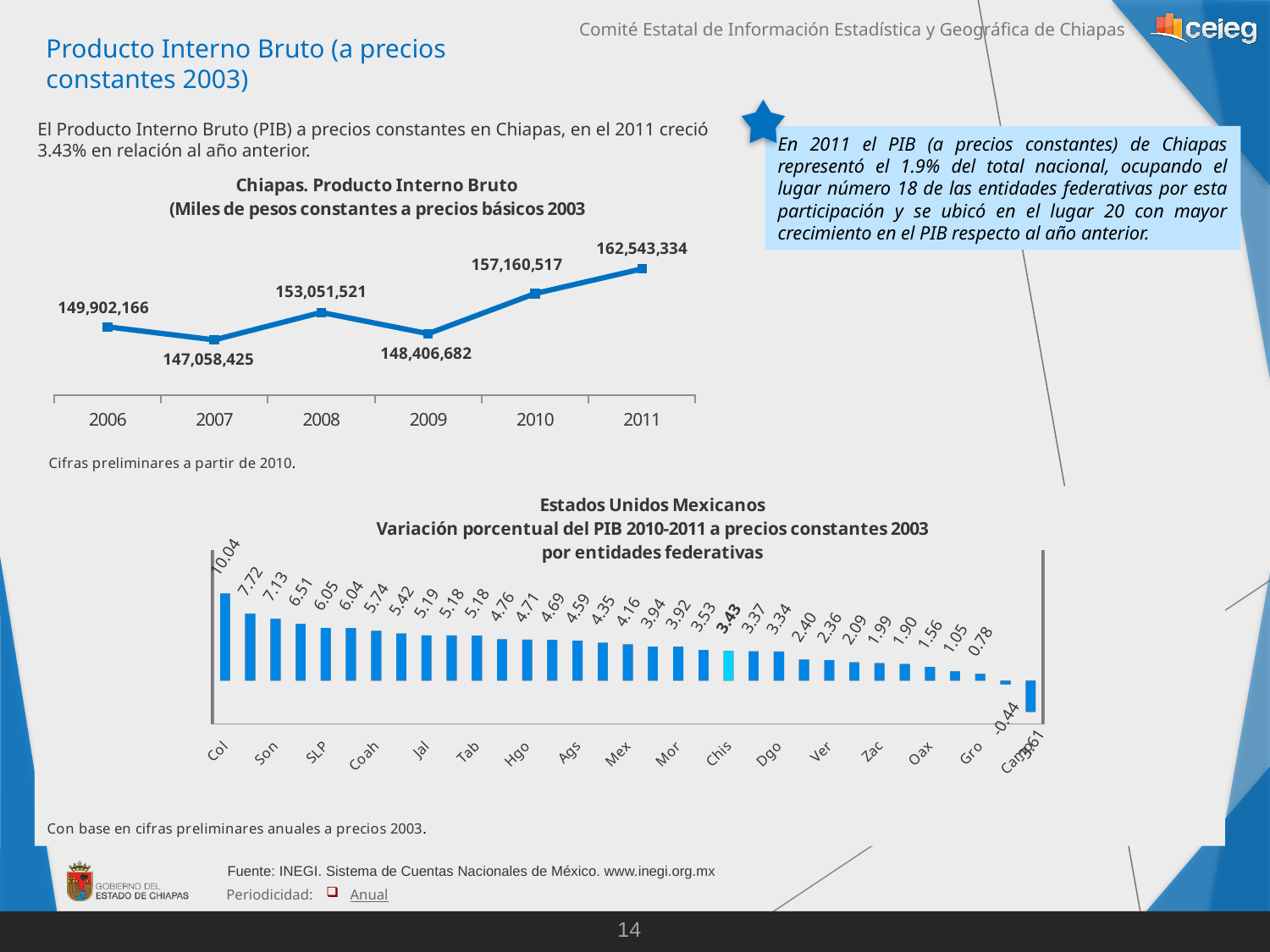
In the 'Chiapas. Producto Interno Bruto' chart, what is the difference between the 2011 and 2010 values? 5,382,817 In the 'Variación porcentual del PIB 2010-2011' bar chart, what is the value for Chis? 3.43 How many years are plotted in the 'Chiapas. Producto Interno Bruto' chart? 6 In the 'Chiapas. Producto Interno Bruto' chart, which year has the highest value? 2011 In the 'Variación porcentual del PIB 2010-2011' bar chart, which entity has the highest value? Col What kind of chart is the 'Chiapas. Producto Interno Bruto' chart? line chart In the 'Chiapas. Producto Interno Bruto' chart, which year has the lowest value? 2007 In the 'Chiapas. Producto Interno Bruto' chart, what is the value for 2007? 147,058,425 In the 'Variación porcentual del PIB 2010-2011' bar chart, do the values rise or fall from left to right? fall In the 'Chiapas. Producto Interno Bruto' chart, which year has the larger value, 2008 or 2009? 2008 In the 'Chiapas. Producto Interno Bruto' chart, what is the value for 2011? 162,543,334 What kind of chart is the 'Estados Unidos Mexicanos Variación porcentual del PIB 2010-2011' chart? bar chart